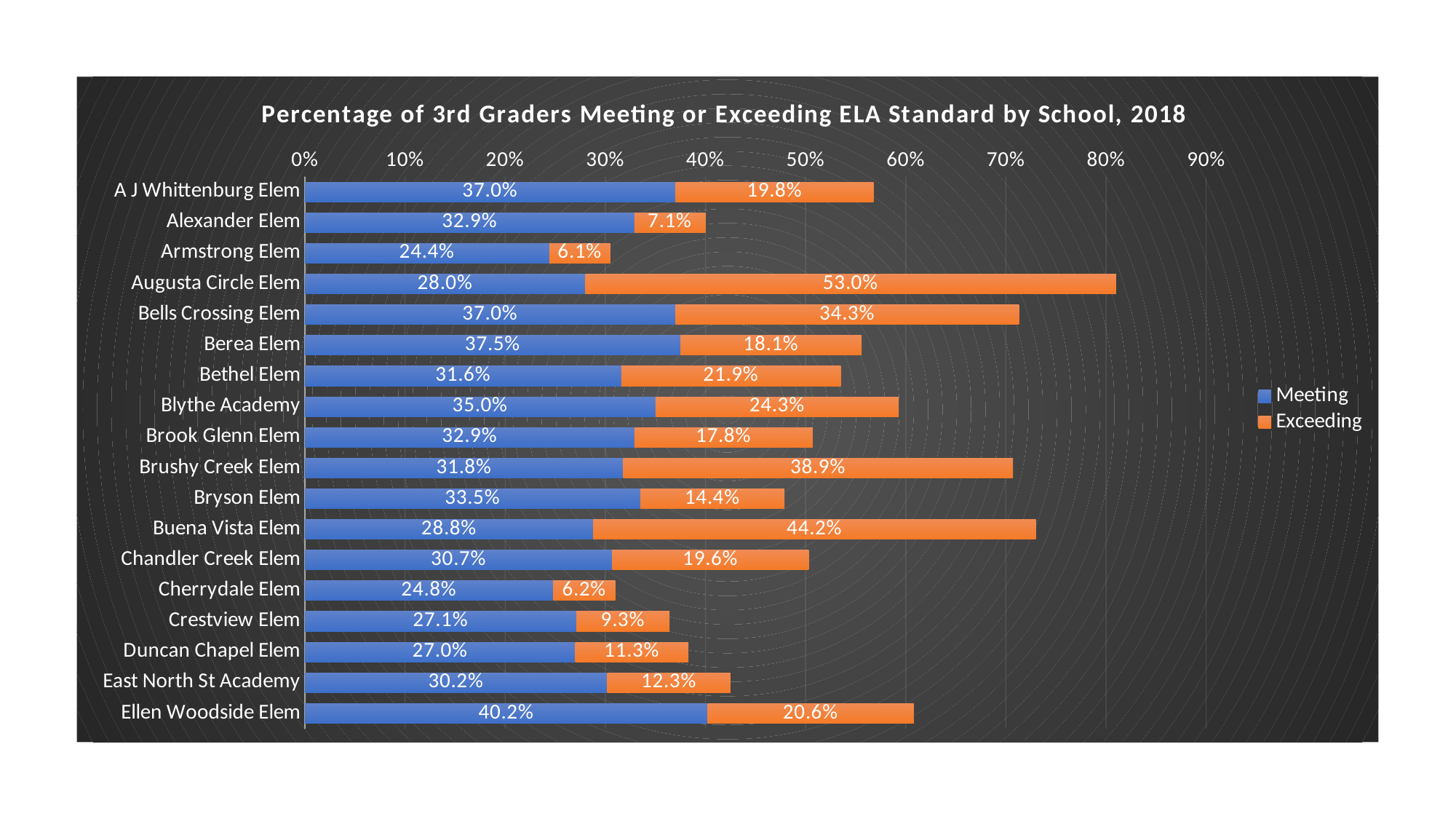
What is the Exceeding percentage for Brushy Creek Elem? 38.9% What is the title of the chart? Percentage of 3rd Graders Meeting or Exceeding ELA Standard by School, 2018 How many series does the legend list? 2 How many schools are shown on the chart? 18 What is the difference between the Exceeding and Meeting percentages for Augusta Circle Elem? 25.0 percentage points Which school has the lowest Meeting percentage? Armstrong Elem Which school has the larger Exceeding percentage, Buena Vista Elem or Brushy Creek Elem? Buena Vista Elem What type of chart is shown on the slide? Stacked bar chart Which school has the highest Exceeding percentage? Augusta Circle Elem What is the Meeting percentage for Blythe Academy? 35.0% What is the combined Meeting and Exceeding percentage for Augusta Circle Elem? 81.0% Which school has the highest Meeting percentage? Ellen Woodside Elem